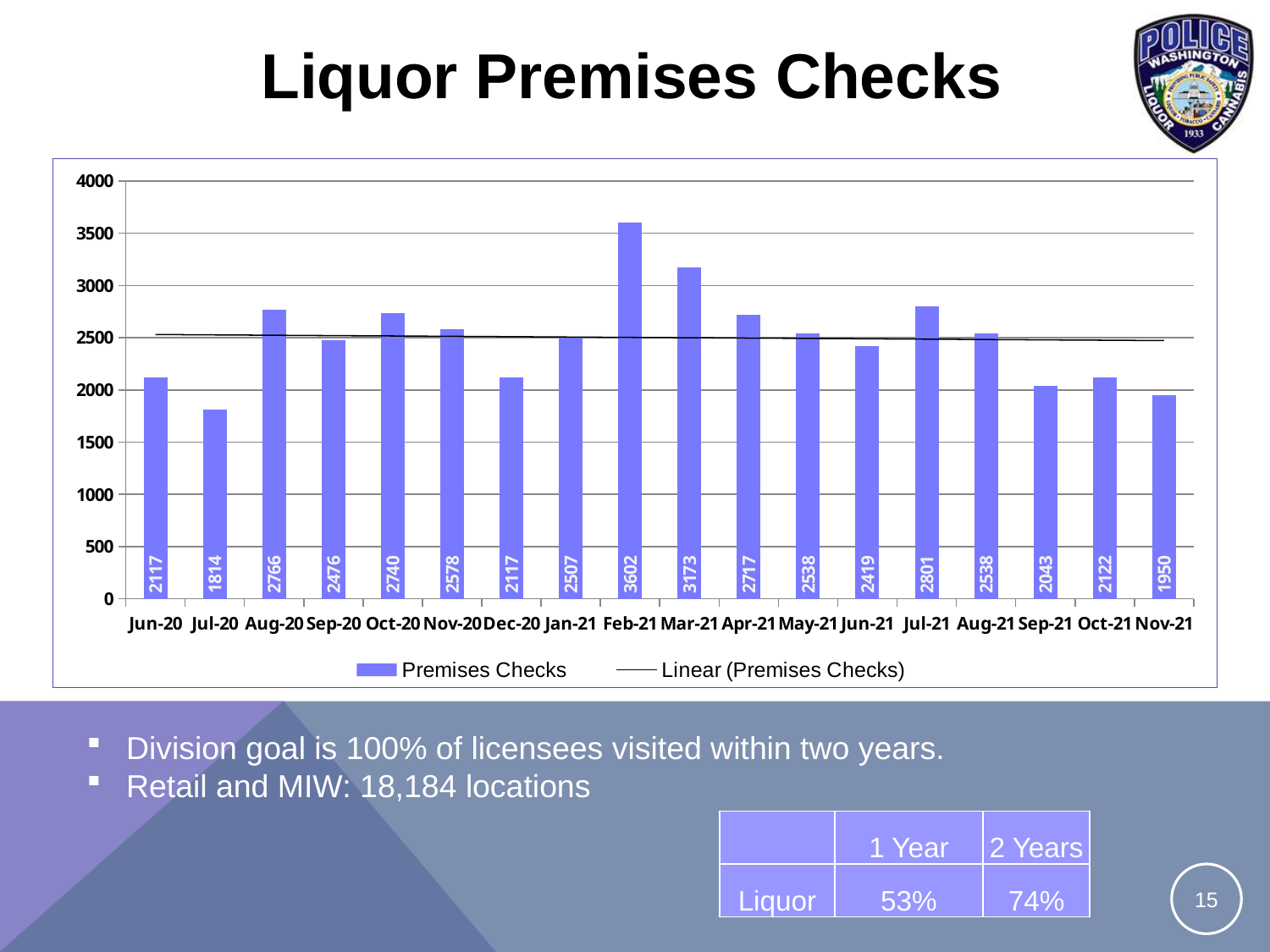
Does the linear trend line rise or fall from Jun-20 to Nov-21? fall How many premises checks were recorded in Feb-21? 3602 What is the difference between the premises checks in Feb-21 and Mar-21? 429 Is the value for Jul-21 greater or less than 2500? greater Which month has the highest number of premises checks? Feb-21 How many entries does the chart legend list? 2 What is the value of Premises Checks for Nov-21? 1950 Which month has the lowest number of premises checks? Jul-20 What kind of chart is shown on the slide? bar chart What is the value of Premises Checks for Jul-20? 1814 How many months are shown on the x axis of the chart? 18 Which month had more premises checks, Aug-20 or Oct-20? Aug-20